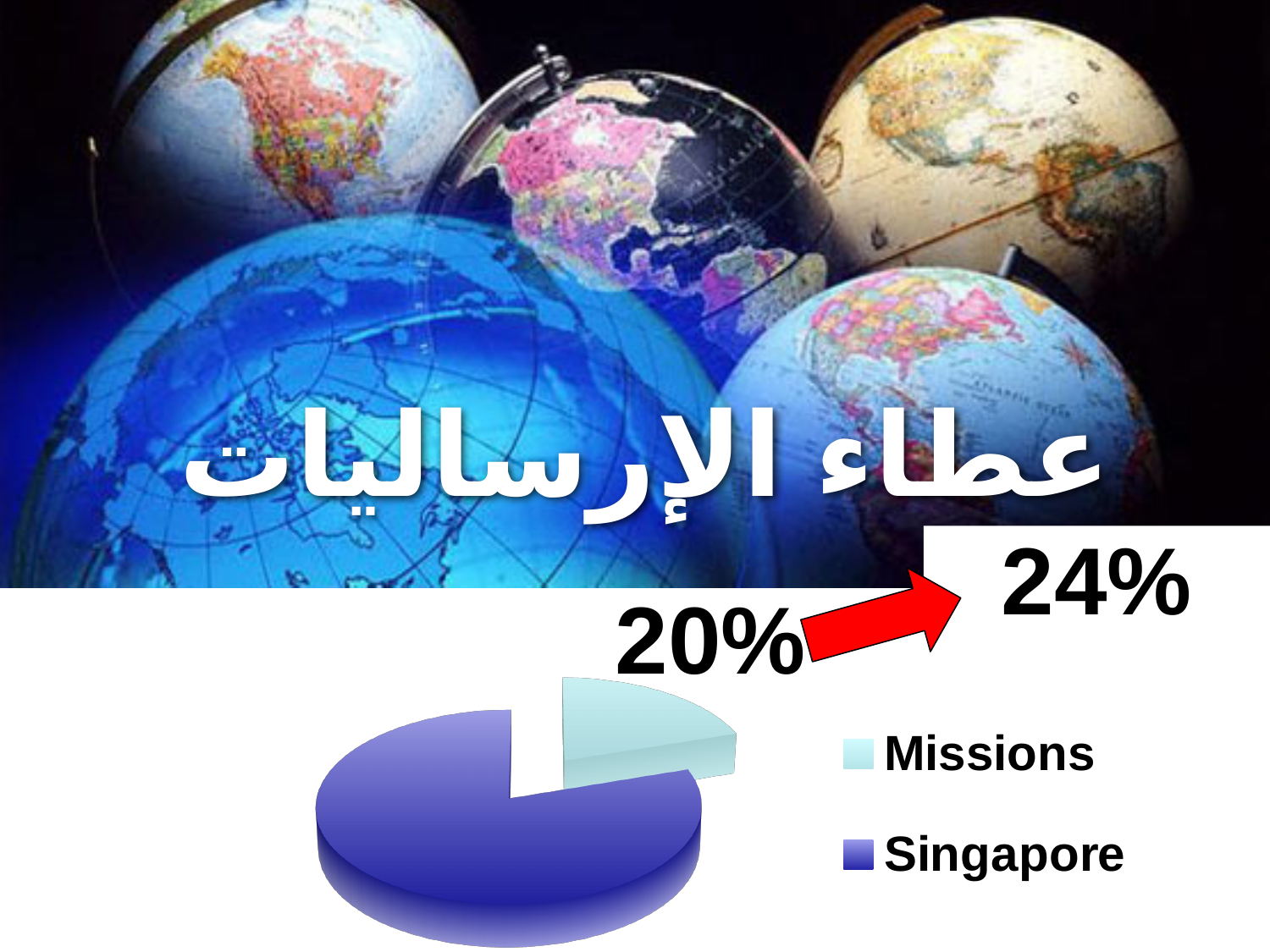
What percentage is labelled next to the Missions slice of the pie chart? 20% How many slices does the pie chart have? 2 Is the Singapore slice of the pie chart greater or less than 50% of the pie? greater Which slice of the pie chart is the smallest? Missions Is the Missions slice of the pie chart greater or less than 50% of the pie? less Which is larger in the pie chart, the Missions slice or the Singapore slice? Singapore What are the two legend entries of the pie chart? Missions and Singapore Which slice of the pie chart is the largest? Singapore What percentage does the red arrow on the slide point to? 24% What kind of chart is shown on the slide? pie chart How many entries does the legend of the pie chart list? 2